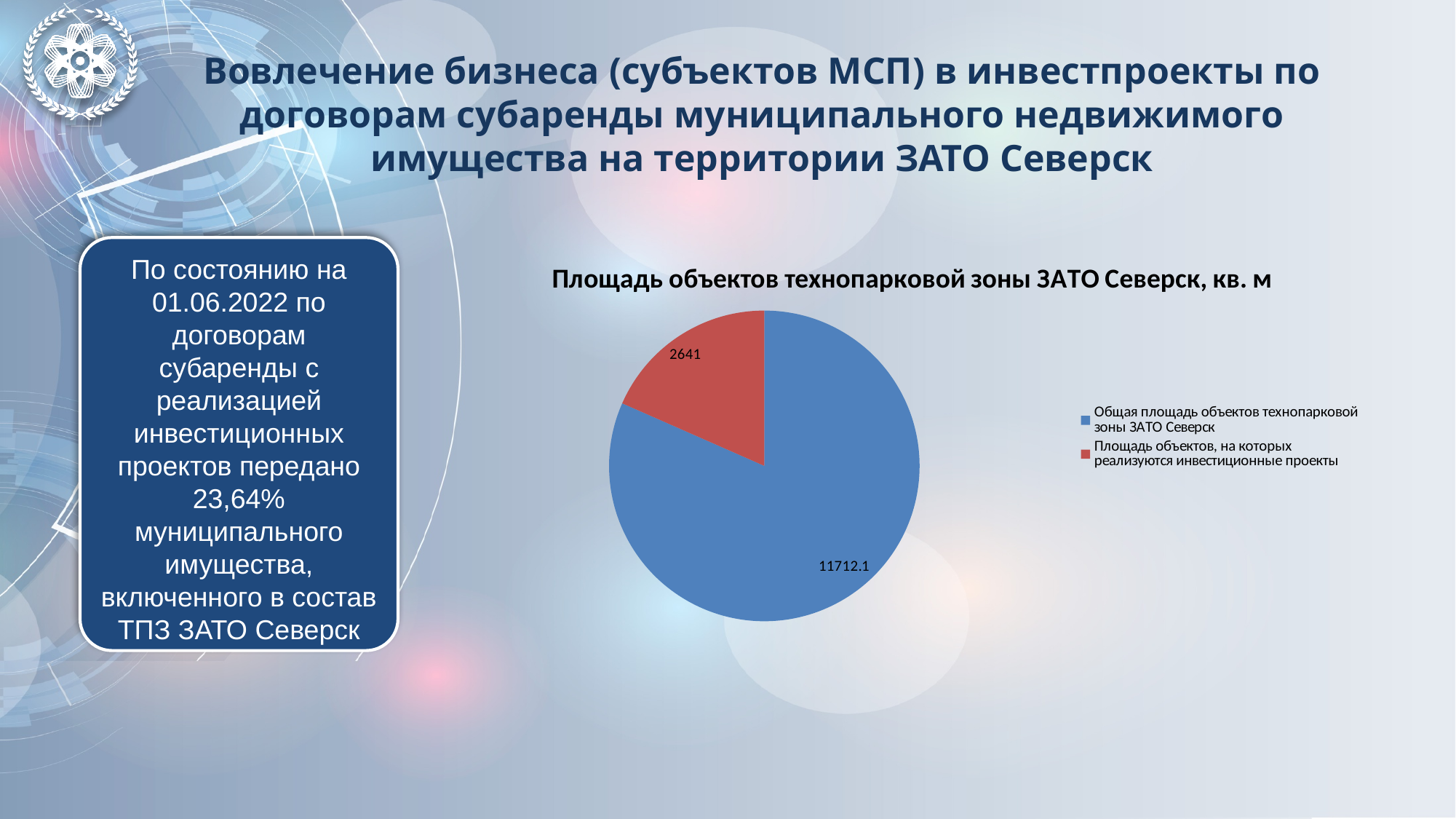
What type of chart is shown on the slide? pie chart How many entries does the chart legend list? 2 Which slice of the pie chart is the smallest? Площадь объектов, на которых реализуются инвестиционные проекты What value is shown for "Общая площадь объектов технопарковой зоны ЗАТО Северск"? 11712.1 Which is larger: the value for "Общая площадь объектов технопарковой зоны ЗАТО Северск" or the value for "Площадь объектов, на которых реализуются инвестиционные проекты"? Общая площадь объектов технопарковой зоны ЗАТО Северск What colour is the slice labelled 2641? red How many slices does the pie chart have? 2 What is the title of the chart? Площадь объектов технопарковой зоны ЗАТО Северск, кв. м What value is shown for "Площадь объектов, на которых реализуются инвестиционные проекты"? 2641 What is the sum of the two values shown on the pie chart? 14353.1 Which slice of the pie chart is the largest? Общая площадь объектов технопарковой зоны ЗАТО Северск What is the difference between the value 11712.1 and the value 2641 shown on the pie chart? 9071.1